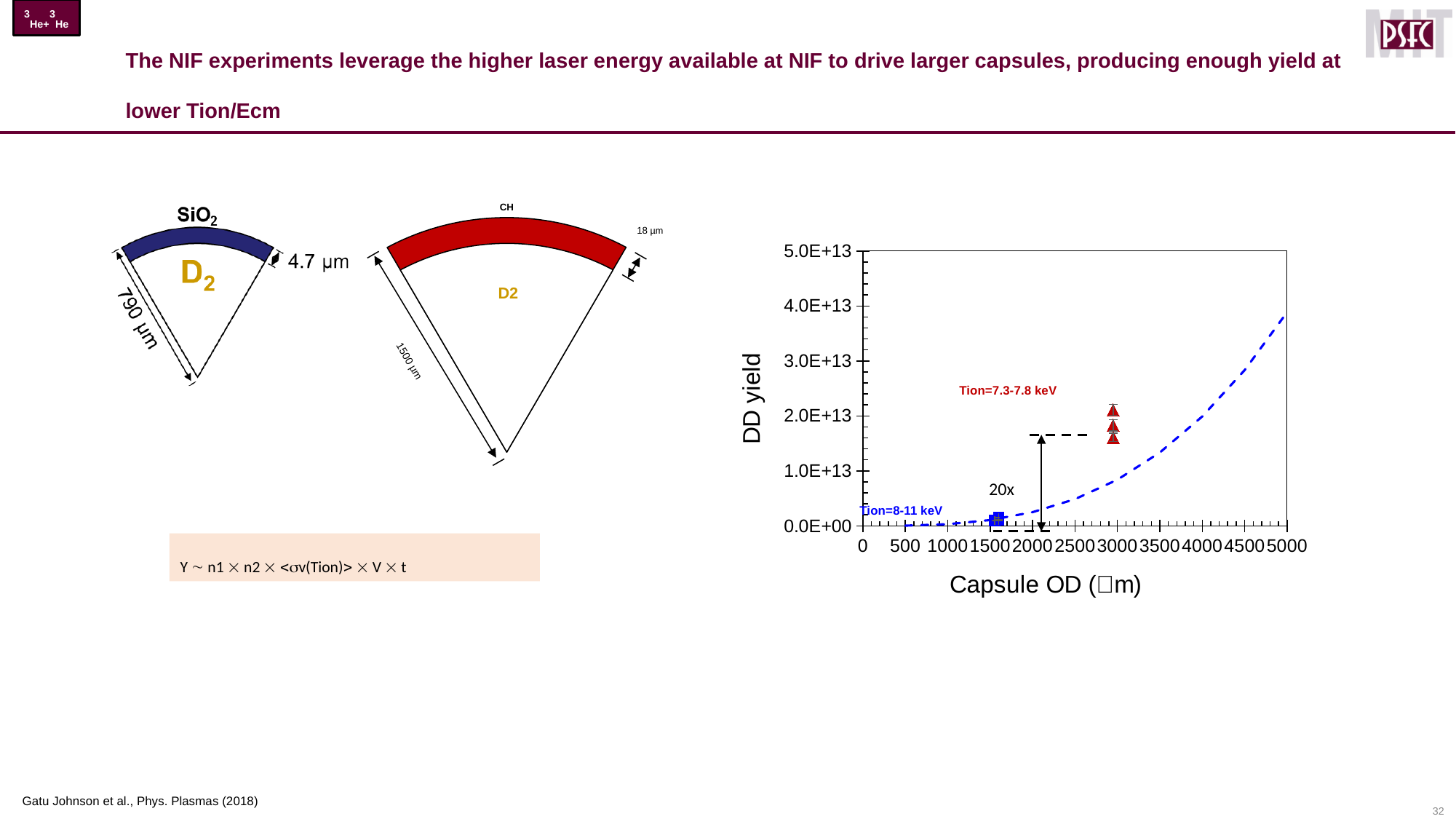
In the DD yield chart, are the blue square data points greater or less than 1.0E+13? less In the DD yield chart, are the blue square points at a capsule OD greater or less than 2000? less In the DD yield chart, which have the higher DD yield: the red triangle points or the blue square points? red triangle points What is the label of the x axis of the DD yield chart? Capsule OD (μm) What factor is annotated next to the vertical arrow in the DD yield chart? 20x In the DD yield chart, are the red triangle points at a capsule OD greater or less than 2500? greater How many red triangle data points are plotted in the DD yield chart? 3 What kind of chart is shown on the right of the slide? scatter chart Does the dashed curve in the DD yield chart rise or fall as Capsule OD increases? rise